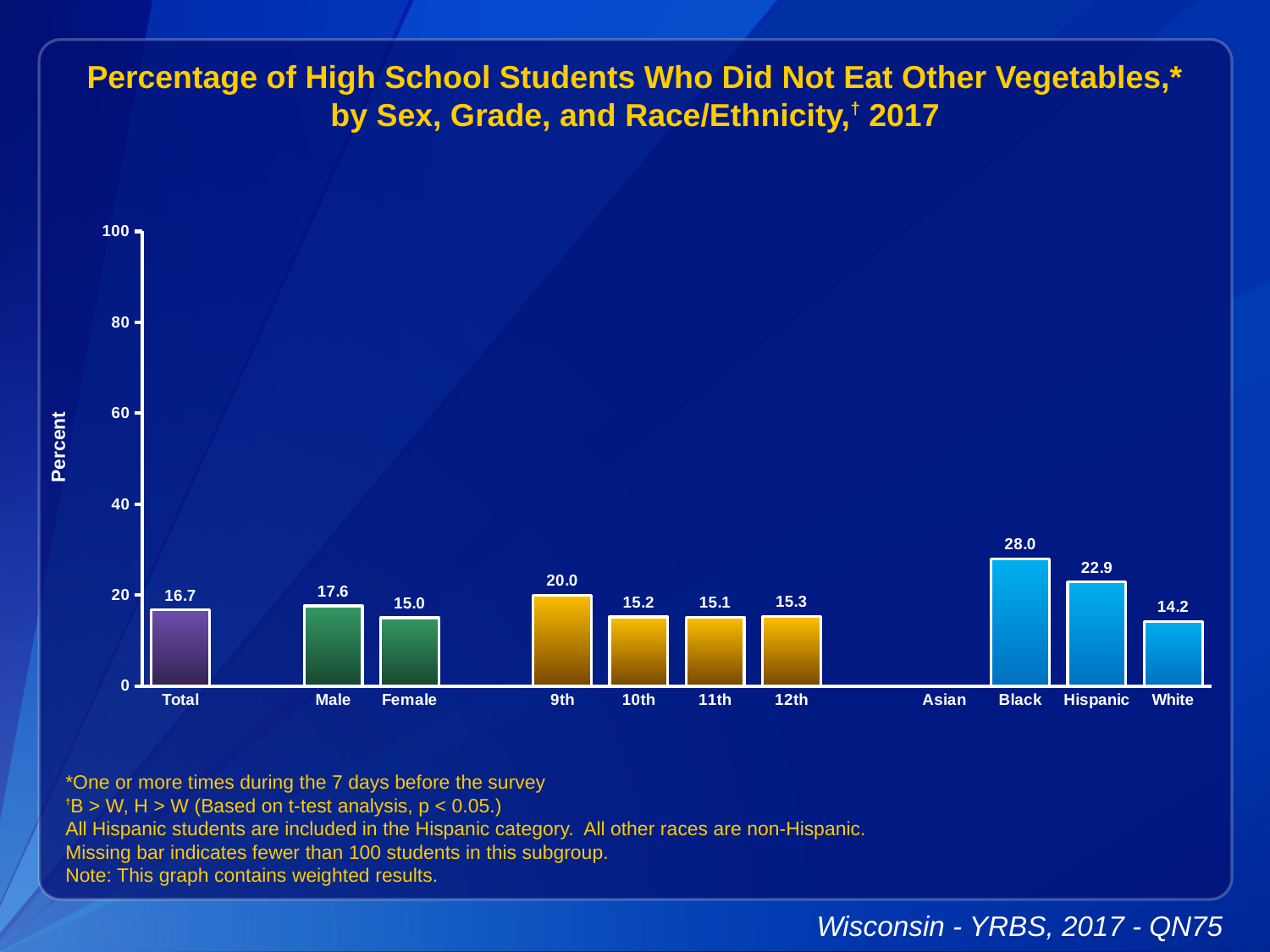
What percentage of Black students did not eat other vegetables? 28.0 Which is larger, the value for 9th grade or the value for 12th grade? 9th grade Is the value for Hispanic students greater or less than 20? greater What is the value shown for 9th grade students? 20.0 What is the difference between the values for Male and Female students? 2.6 Which race/ethnicity category has no bar plotted on the chart? Asian What is the value shown for the Total bar? 16.7 What kind of chart is shown on the slide? Bar chart What is the difference between the values for Black and Hispanic students? 5.1 Which category has the highest value on the chart? Black What is the value shown for Female students? 15.0 Which category has the lowest value on the chart? White